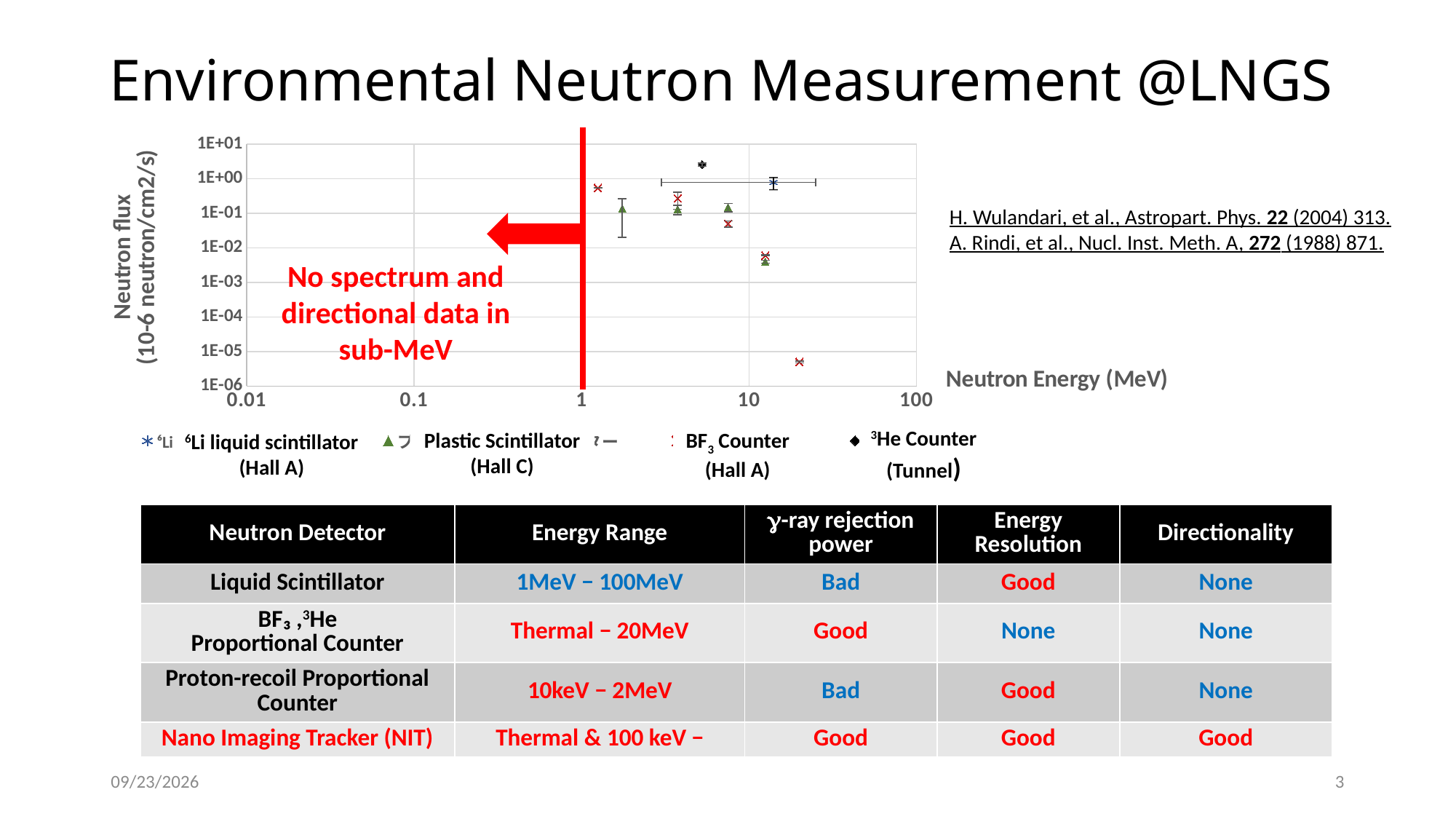
What is the label of the chart's x axis? Neutron Energy (MeV) Is the neutron flux value for the 3He Counter (Tunnel) point greater or less than 1E+00? greater How many series does the chart legend list? 4 Is the Plastic Scintillator (Hall C) point near 12 MeV greater or less than 1E-02? less Do the BF3 Counter (Hall A) values rise or fall as neutron energy increases from 10 MeV to 20 MeV? fall What kind of chart is shown on the slide? scatter chart Which series has the highest neutron flux point on the chart? 3He Counter (Tunnel) How many tick labels are shown on the chart's x axis? 5 Is the 6Li liquid scintillator (Hall A) point near 13 MeV greater or less than 1E-01? greater What is the label of the chart's y axis? Neutron flux (10-6 neutron/cm2/s) Which is larger: the 3He Counter (Tunnel) point near 5 MeV or the Plastic Scintillator (Hall C) point near 2 MeV? 3He Counter (Tunnel)